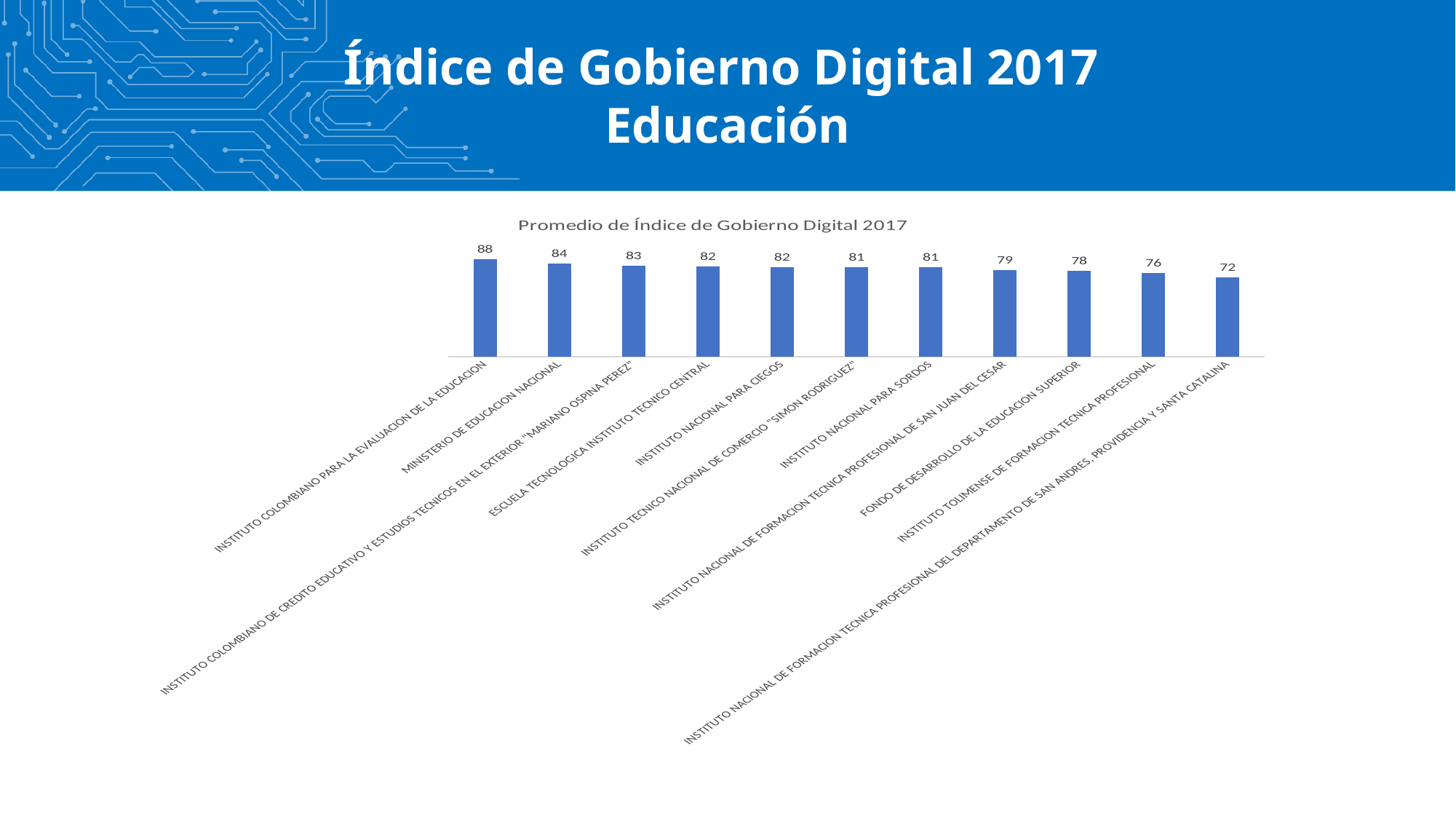
Do the values rise or fall from left to right along the x axis? Fall What is the difference between the values for MINISTERIO DE EDUCACION NACIONAL and INSTITUTO TOLIMENSE DE FORMACION TECNICA PROFESIONAL? 8 What kind of chart is shown on the slide? Bar chart What is the title of the chart? Promedio de Índice de Gobierno Digital 2017 What is the value for MINISTERIO DE EDUCACION NACIONAL? 84 What is the difference between the highest value (88) and the lowest value (72)? 16 What is the value for FONDO DE DESARROLLO DE LA EDUCACION SUPERIOR? 78 How many categories are shown in the chart? 11 Which is larger, the value for ESCUELA TECNOLOGICA INSTITUTO TECNICO CENTRAL or the value for INSTITUTO NACIONAL DE FORMACION TECNICA PROFESIONAL DE SAN JUAN DEL CESAR? ESCUELA TECNOLOGICA INSTITUTO TECNICO CENTRAL Which category has the lowest value? INSTITUTO NACIONAL DE FORMACION TECNICA PROFESIONAL DEL DEPARTAMENTO DE SAN ANDRES, PROVIDENCIA Y SANTA CATALINA Which category has the highest value? INSTITUTO COLOMBIANO PARA LA EVALUACION DE LA EDUCACION What is the value for INSTITUTO NACIONAL PARA CIEGOS? 82